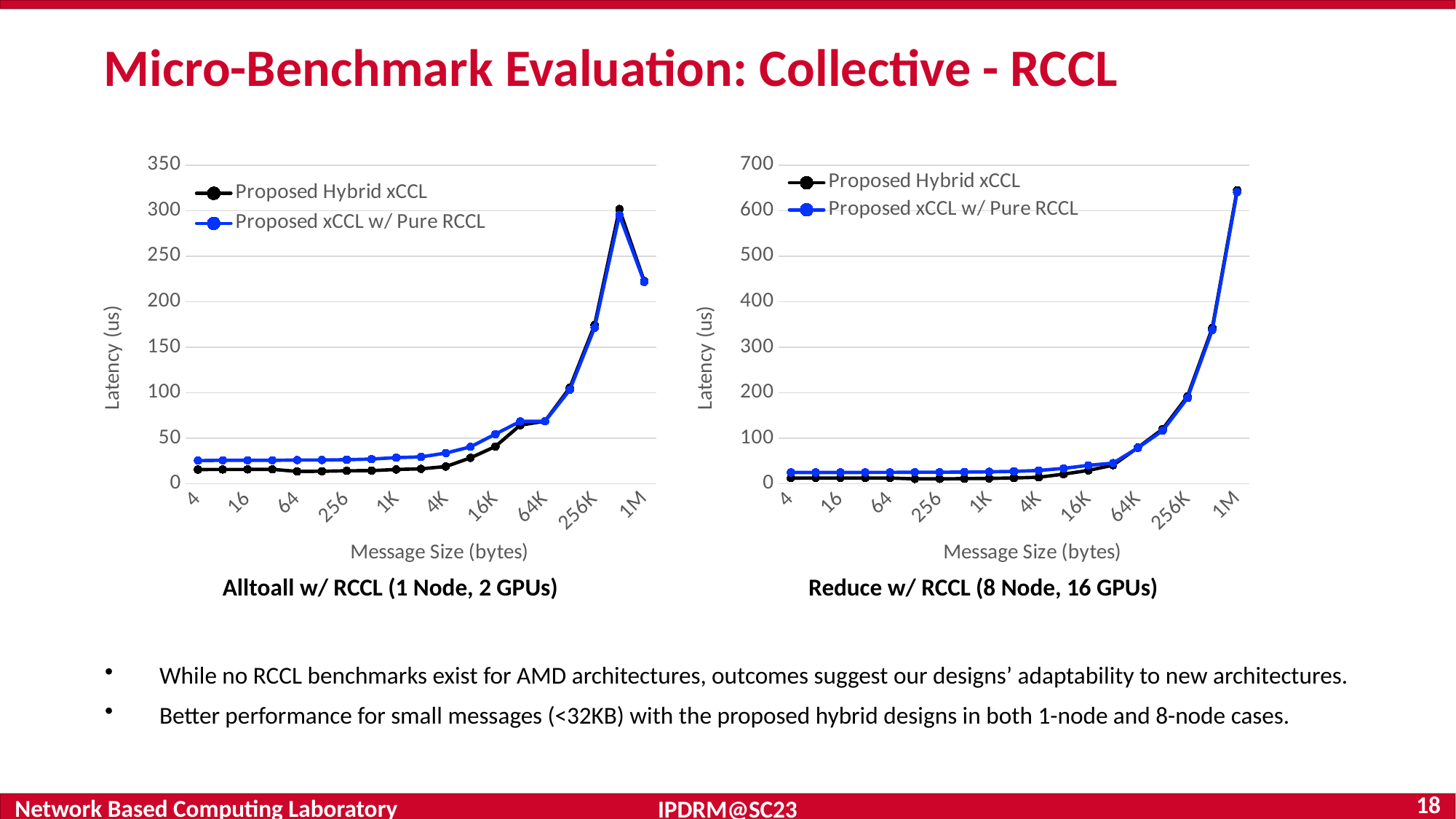
In the Reduce w/ RCCL (8 Node, 16 GPUs) chart, which colour is used for the Proposed Hybrid xCCL series? black In the Alltoall w/ RCCL (1 Node, 2 GPUs) chart, which series has the higher latency at a message size of 4 bytes? Proposed xCCL w/ Pure RCCL In the Reduce w/ RCCL (8 Node, 16 GPUs) chart, does latency rise or fall as message size increases? rise In the Reduce w/ RCCL (8 Node, 16 GPUs) chart, is the latency at 1M greater or less than 600? greater In the Reduce w/ RCCL (8 Node, 16 GPUs) chart, is the latency at 64K greater or less than 100? less How many message-size tick labels are shown on the x axis of the Reduce w/ RCCL (8 Node, 16 GPUs) chart? 10 How many series does the legend of the Reduce w/ RCCL (8 Node, 16 GPUs) chart list? 2 What kind of chart is the Alltoall w/ RCCL (1 Node, 2 GPUs) chart? line chart In the Alltoall w/ RCCL (1 Node, 2 GPUs) chart, is the latency of Proposed xCCL w/ Pure RCCL at 1M greater or less than 200? greater What is the y-axis label of the Alltoall w/ RCCL (1 Node, 2 GPUs) chart? Latency (us)